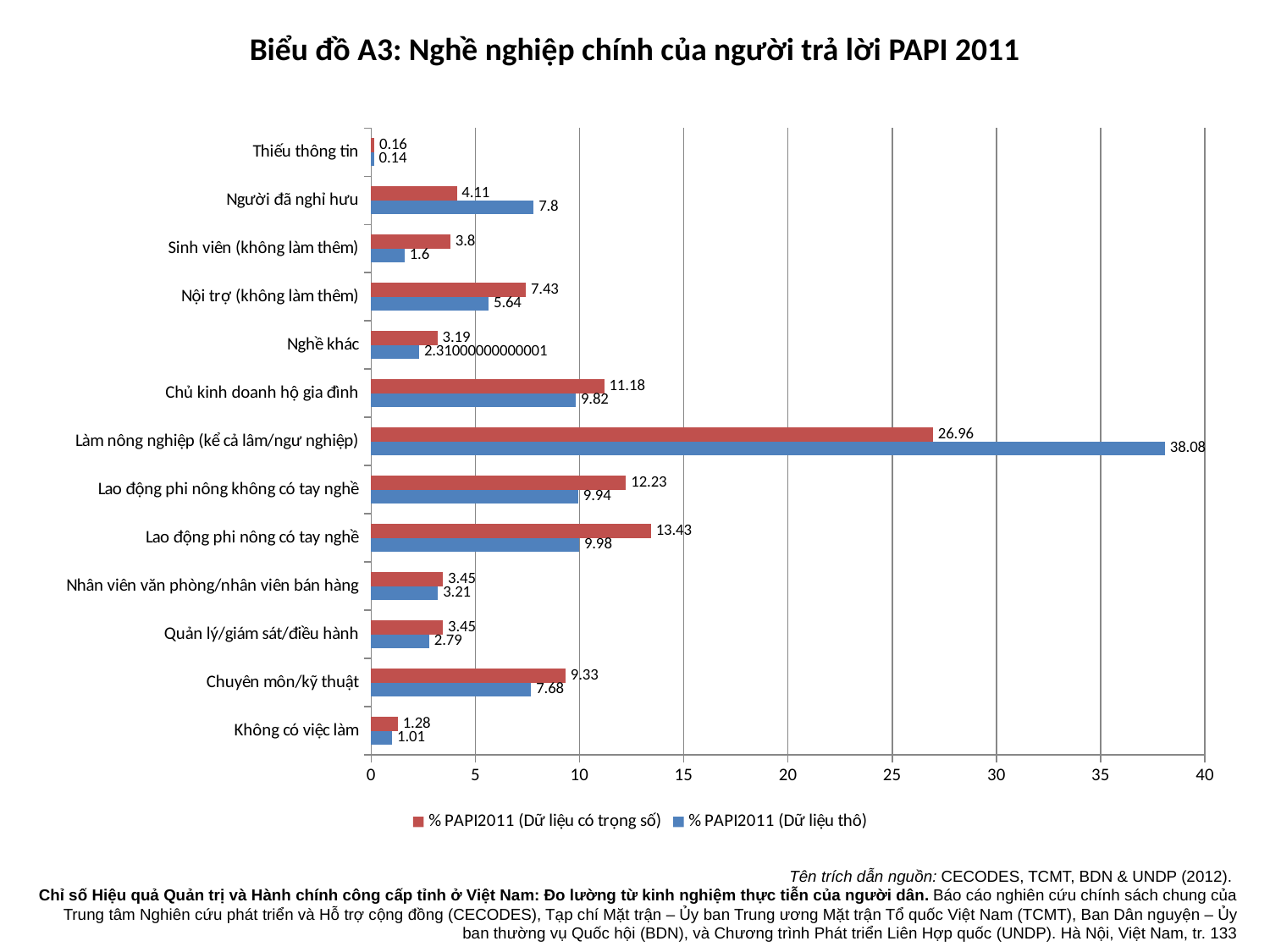
How many occupation categories are shown on the chart? 13 What is the value for Chuyên môn/kỹ thuật in the % PAPI2011 (Dữ liệu có trọng số) series? 9.33 What type of chart is shown on the slide? Bar chart What is the difference between the % PAPI2011 (Dữ liệu thô) and % PAPI2011 (Dữ liệu có trọng số) values for Làm nông nghiệp (kể cả lâm/ngư nghiệp)? 11.12 What is the value for Người đã nghỉ hưu in the % PAPI2011 (Dữ liệu thô) series? 7.8 For Sinh viên (không làm thêm), which series has the larger value: % PAPI2011 (Dữ liệu có trọng số) or % PAPI2011 (Dữ liệu thô)? % PAPI2011 (Dữ liệu có trọng số) What is the title of the chart? Biểu đồ A3: Nghề nghiệp chính của người trả lời PAPI 2011 Is the value for Lao động phi nông có tay nghề in the % PAPI2011 (Dữ liệu có trọng số) series greater or less than 10? greater Which category has the highest value in the % PAPI2011 (Dữ liệu có trọng số) series? Làm nông nghiệp (kể cả lâm/ngư nghiệp) How many series does the legend list? 2 Which category has the lowest value in the % PAPI2011 (Dữ liệu thô) series? Thiếu thông tin What is the value for Làm nông nghiệp (kể cả lâm/ngư nghiệp) in the % PAPI2011 (Dữ liệu thô) series? 38.08